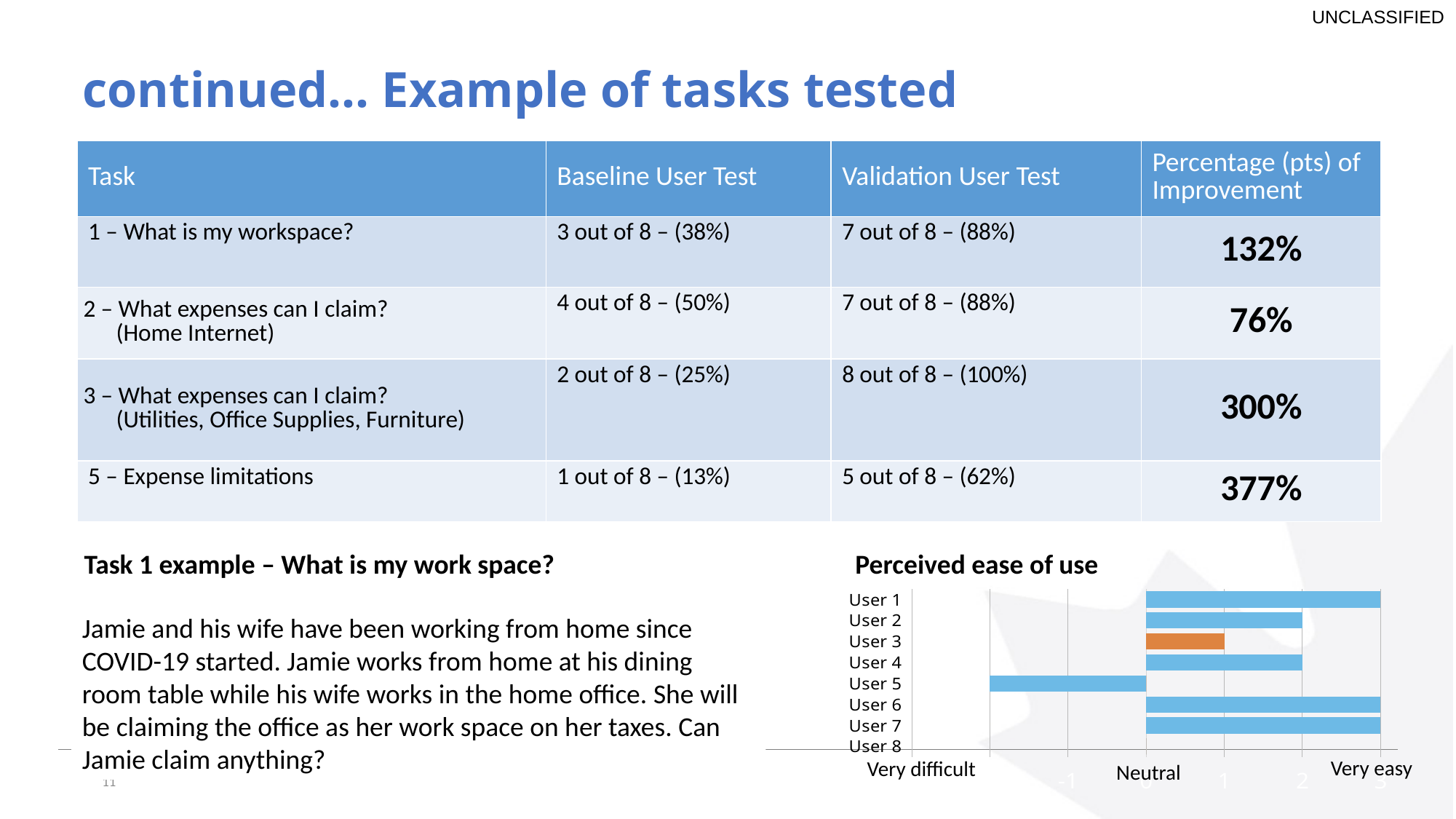
What kind of chart is the "Perceived ease of use" chart? bar chart In the "Perceived ease of use" chart, which is larger, the value for User 3 or User 4? User 4 In the "Perceived ease of use" chart, which is larger, the value for User 1 or User 2? User 1 In the "Perceived ease of use" chart, what is the value for User 2? 2 In the "Perceived ease of use" chart, which user has the lowest rating? User 5 In the "Perceived ease of use" chart, what is the value for User 3? 1 In the "Perceived ease of use" chart, is the value for User 5 greater or less than -1? less In the "Perceived ease of use" chart, which user's bar is coloured orange instead of blue? User 3 In the "Perceived ease of use" chart, is the value for User 1 greater or less than 2? greater How many users are listed on the "Perceived ease of use" chart? 8 In the "Perceived ease of use" chart, is the value for User 3 greater or less than 2? less What is the title of the chart on the slide? Perceived ease of use